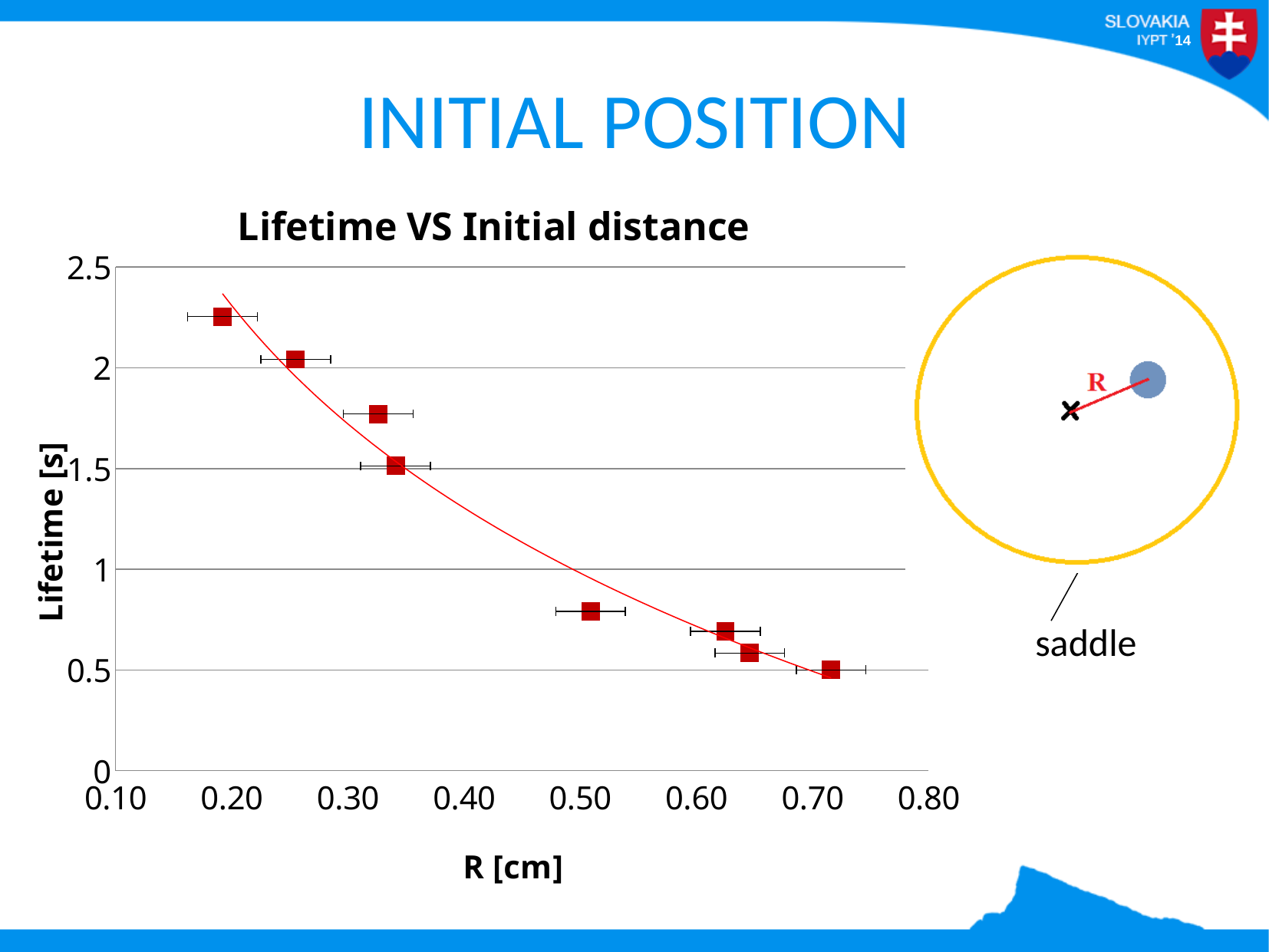
What kind of chart is "Lifetime VS Initial distance"? scatter chart How many data points are plotted in the "Lifetime VS Initial distance" chart? 8 What is the label of the x axis in the "Lifetime VS Initial distance" chart? R [cm] In the "Lifetime VS Initial distance" chart, is the lifetime of the data point near R = 0.62 cm greater or less than 1 s? less In the "Lifetime VS Initial distance" chart, is the lifetime of the data point near R = 0.33 cm greater or less than 1.5 s? greater In the "Lifetime VS Initial distance" chart, is the lifetime of the data point at the smallest R (near 0.20 cm) greater or less than 2 s? greater In the "Lifetime VS Initial distance" chart, which data point has the highest lifetime: the one at the smallest R or the one at the largest R? the one at the smallest R In the "Lifetime VS Initial distance" chart, does the lifetime rise or fall as R increases? fall What is the title of the chart on the slide? Lifetime VS Initial distance What is the highest tick value shown on the y axis of the "Lifetime VS Initial distance" chart? 2.5 In the "Lifetime VS Initial distance" chart, is the lifetime at R near 0.20 cm larger or smaller than the lifetime at R near 0.70 cm? larger